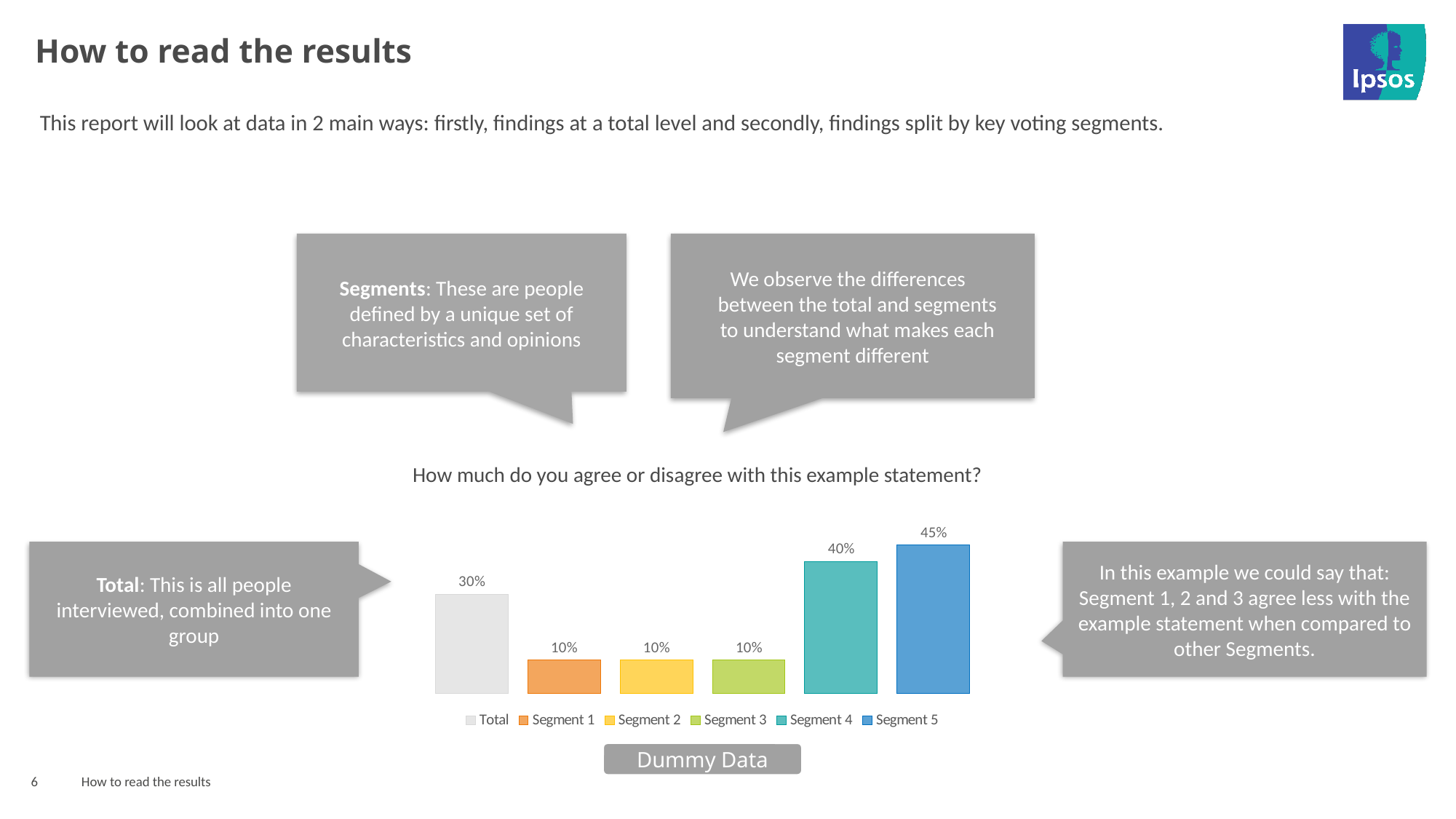
Which is larger, the value for Segment 5 or the value for Segment 4? Segment 5 Which series has the highest value in the chart? Segment 5 What is the value for Total in the chart? 30% How many series does the chart legend list? 6 What is the difference between the values for Segment 5 and Total? 15% What is the value for Segment 4 in the chart? 40% What kind of chart is shown on the slide? Bar chart How many bars are plotted in the chart? 6 Which is larger, the value for Total or the value for Segment 3? Total What question is the chart on the slide about? How much do you agree or disagree with this example statement? What is the value for Segment 1 in the chart? 10% What is the difference between the values for Segment 4 and Segment 2? 30%